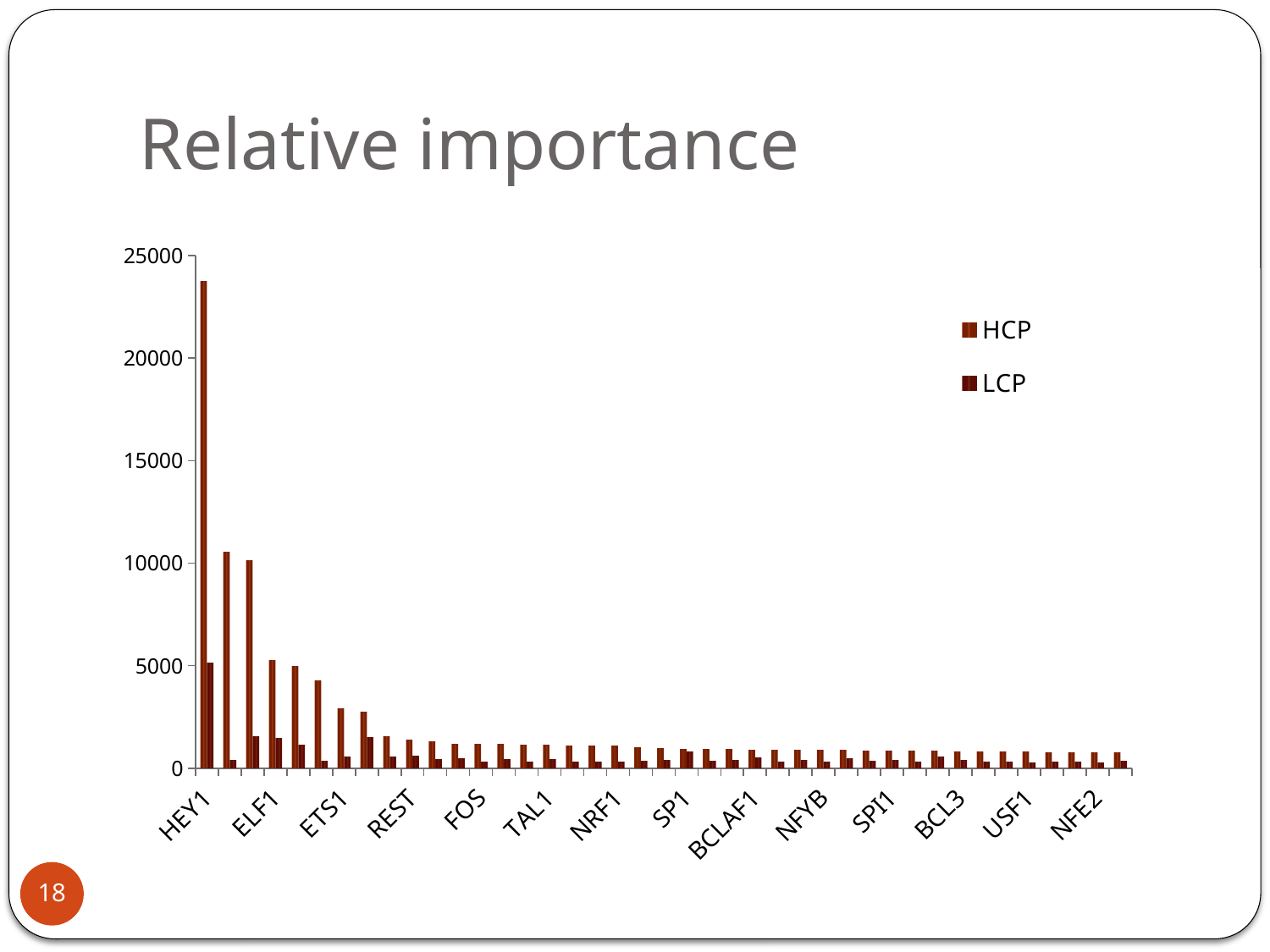
Do the HCP values generally rise or fall moving from left to right along the x axis? fall Is the HCP value for HEY1 greater or less than 20000? greater How many series does the legend list? 2 Is the HCP value for REST greater or less than 5000? less What kind of chart is shown on the slide? bar chart What are the two series named in the legend? HCP and LCP Which category has a larger HCP value, HEY1 or ELF1? HEY1 Which category has the highest HCP value? HEY1 Is the LCP value for ELF1 greater or less than 5000? less For HEY1, which series has the larger value, HCP or LCP? HCP What is the title of the chart? Relative importance